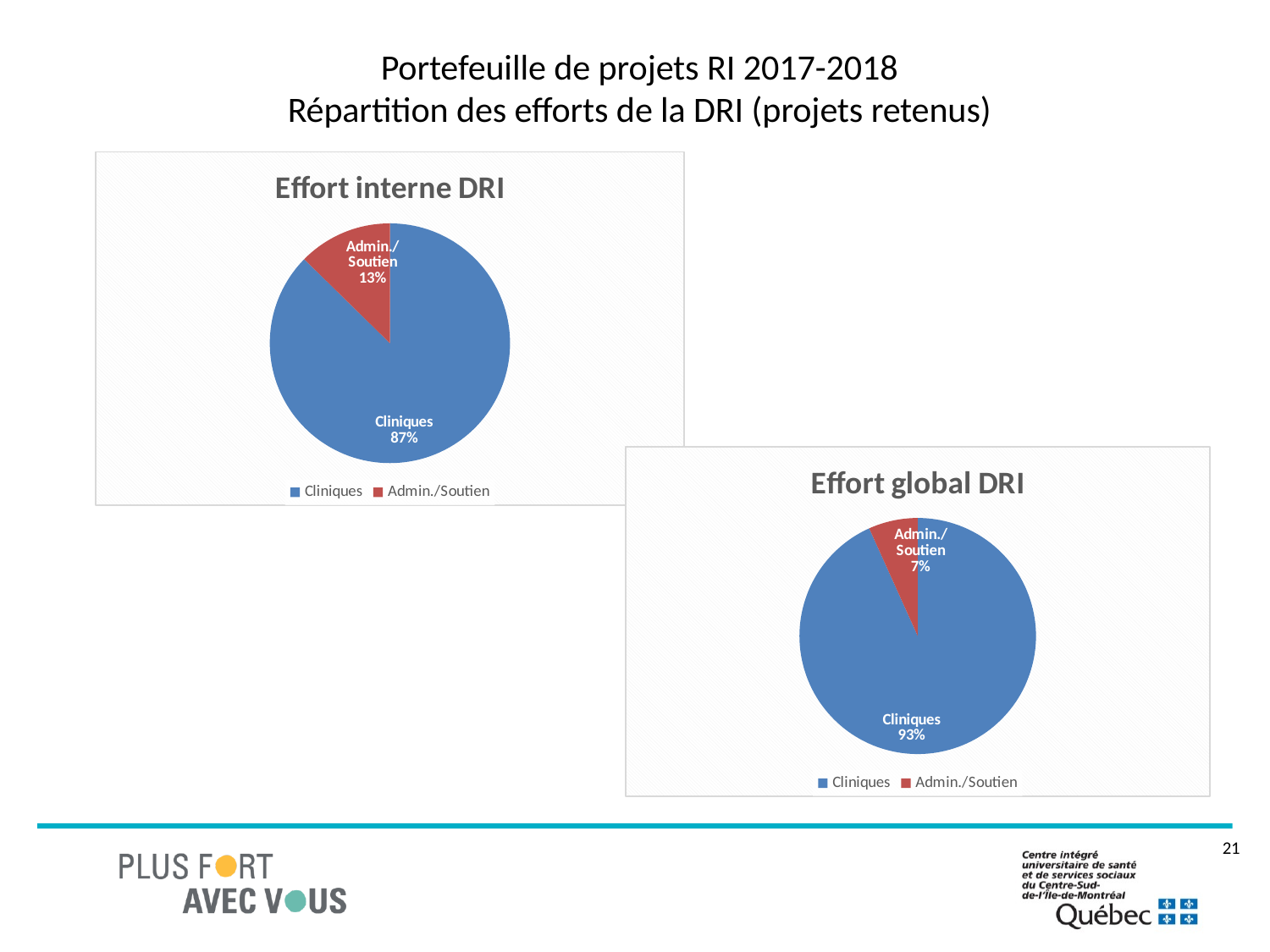
In the 'Effort interne DRI' chart, what is the difference in percentage points between Cliniques and Admin./Soutien? 74 In the 'Effort global DRI' chart, what share does Admin./Soutien have? 7% In the 'Effort global DRI' chart, which category has the smallest slice? Admin./Soutien How many categories does the 'Effort interne DRI' chart show? 2 In the 'Effort global DRI' chart, what share does Cliniques have? 93% Is the Admin./Soutien share larger in the 'Effort interne DRI' chart or in the 'Effort global DRI' chart? Effort interne DRI What type of chart is 'Effort global DRI'? Pie chart In the 'Effort interne DRI' chart, which category has the largest slice? Cliniques In the 'Effort interne DRI' chart, what share does Cliniques have? 87% In the 'Effort global DRI' chart, what is the difference in percentage points between Cliniques and Admin./Soutien? 86 What are the legend entries of the 'Effort global DRI' chart? Cliniques, Admin./Soutien In the 'Effort interne DRI' chart, what share does Admin./Soutien have? 13%